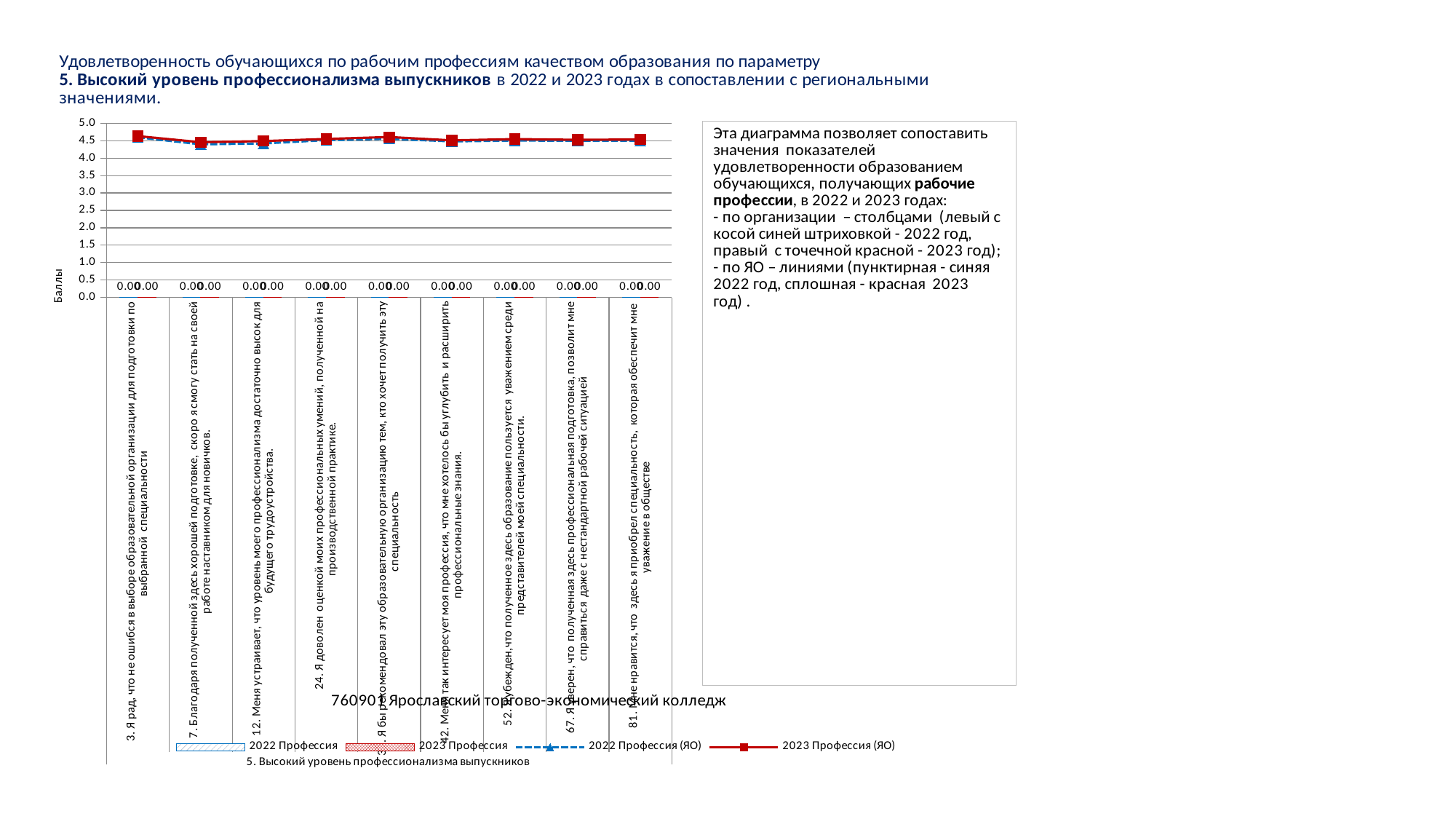
Is the value of the 2023 Профессия (ЯО) line for the statement "52. Убежден, что полученное здесь образование пользуется уважением среди представителей моей специальности." greater or less than 3.5? greater How many series does the chart legend list? 4 Is the value of the 2023 Профессия (ЯО) line for the statement "3. Я рад, что не ошибся в выборе образовательной организации..." greater or less than 4.0? greater Is the value of the 2022 Профессия (ЯО) line for the statement "7. Благодаря полученной здесь хорошей подготовке, скоро я смогу стать на своей работе наставником для новичков." greater or less than 5.0? less What is the label of the chart's vertical axis? Баллы What kind of chart is shown on the slide? A combined bar and line chart How many categories (statements) are plotted along the x axis of the chart? 9 What is the highest tick value shown on the chart's vertical axis? 5.0 What value is printed for the 2022 Профессия bar for the statement "3. Я рад, что не ошибся в выборе образовательной организации для подготовки по выбранной специальности"? 0.00 What value is printed for the 2023 Профессия bar for the statement "81. Мне нравится, что здесь я приобрел специальность, которая обеспечит мне уважение в обществе"? 0.00